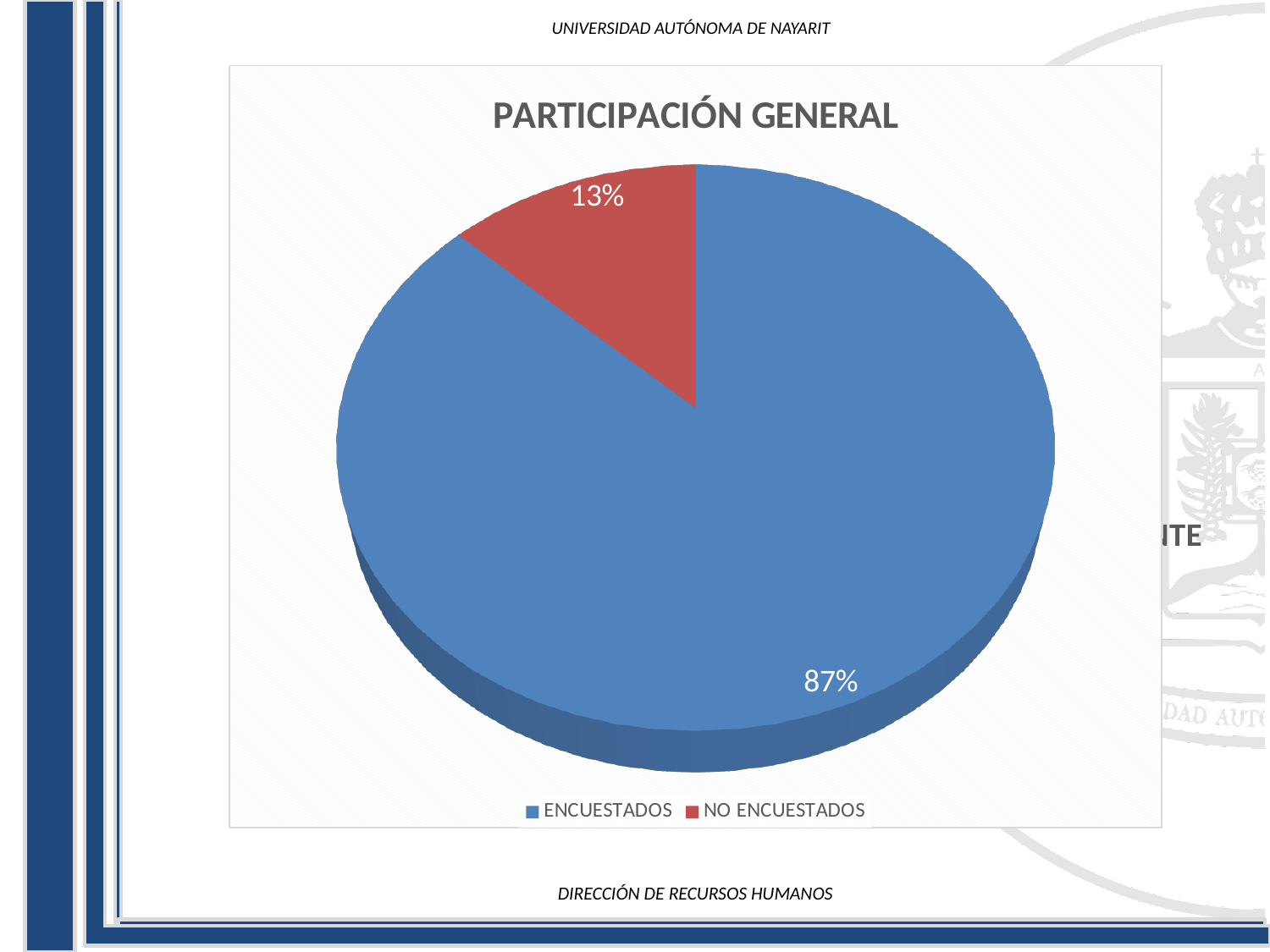
What type of chart is shown on the slide? Pie chart How many entries does the legend list? 2 What is the combined share of ENCUESTADOS and NO ENCUESTADOS? 100% Which category has the smallest share of the pie? NO ENCUESTADOS Which is larger, the share for ENCUESTADOS or the share for NO ENCUESTADOS? ENCUESTADOS What is the title of the chart? PARTICIPACIÓN GENERAL What percentage of the pie is ENCUESTADOS? 87% What colour is the ENCUESTADOS slice? Blue What percentage of the pie is NO ENCUESTADOS? 13% How many categories does the pie chart have? 2 What is the difference in percentage points between ENCUESTADOS and NO ENCUESTADOS? 74 Which category has the largest share of the pie? ENCUESTADOS